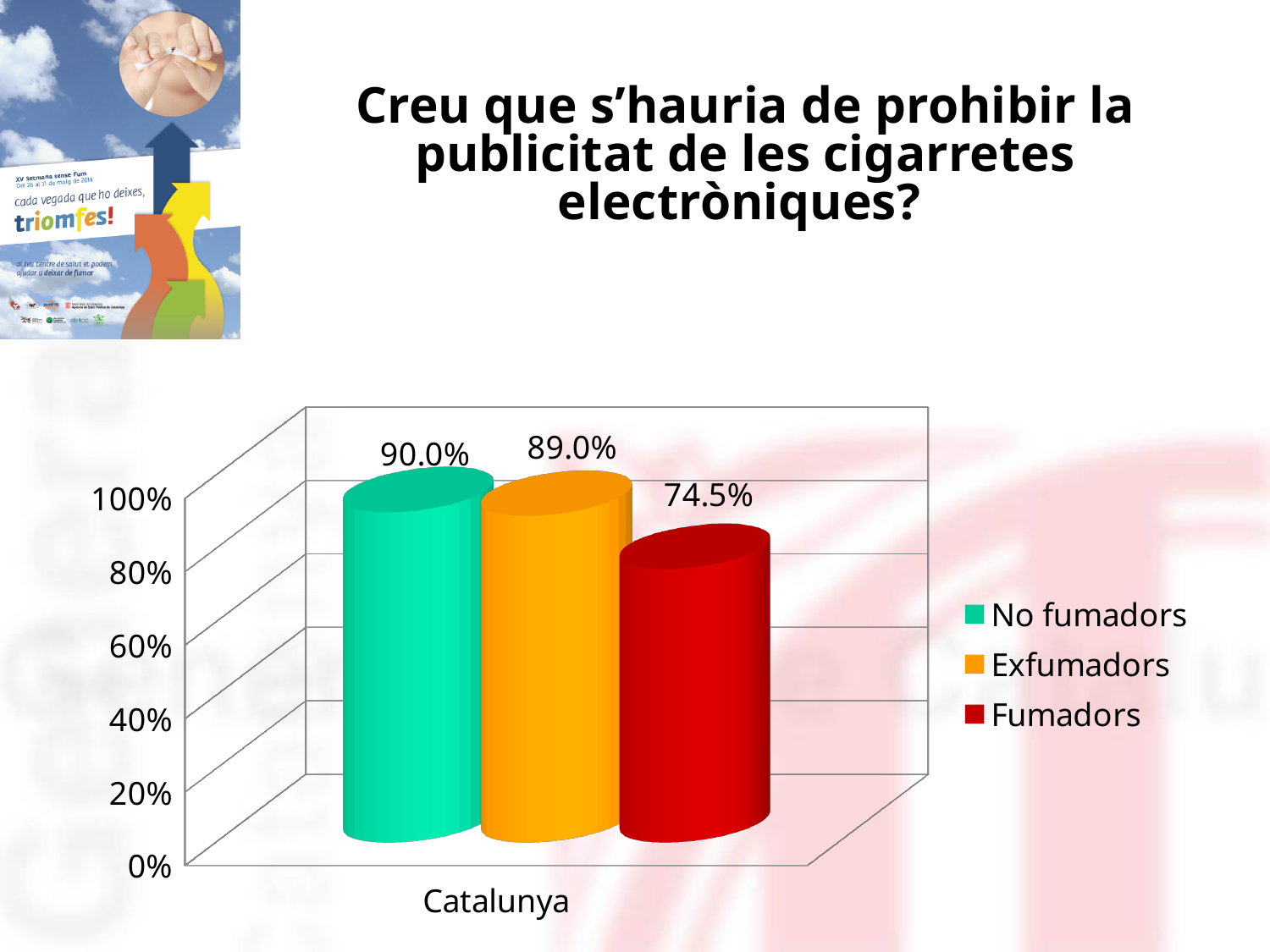
Which is larger, the value for Exfumadors or the value for Fumadors? Exfumadors What kind of chart is shown on the slide? bar chart What colour is the bar for Fumadors? red What is the value for Exfumadors? 89.0% What is the value for Fumadors? 74.5% What is the difference between the values for Exfumadors and Fumadors? 14.5% What is the category label shown on the x axis? Catalunya How many series does the legend list? 3 Is the value for Fumadors greater or less than 80%? less What is the difference between the values for No fumadors and Fumadors? 15.5% Which series has the lowest value? Fumadors What is the value for No fumadors? 90.0%